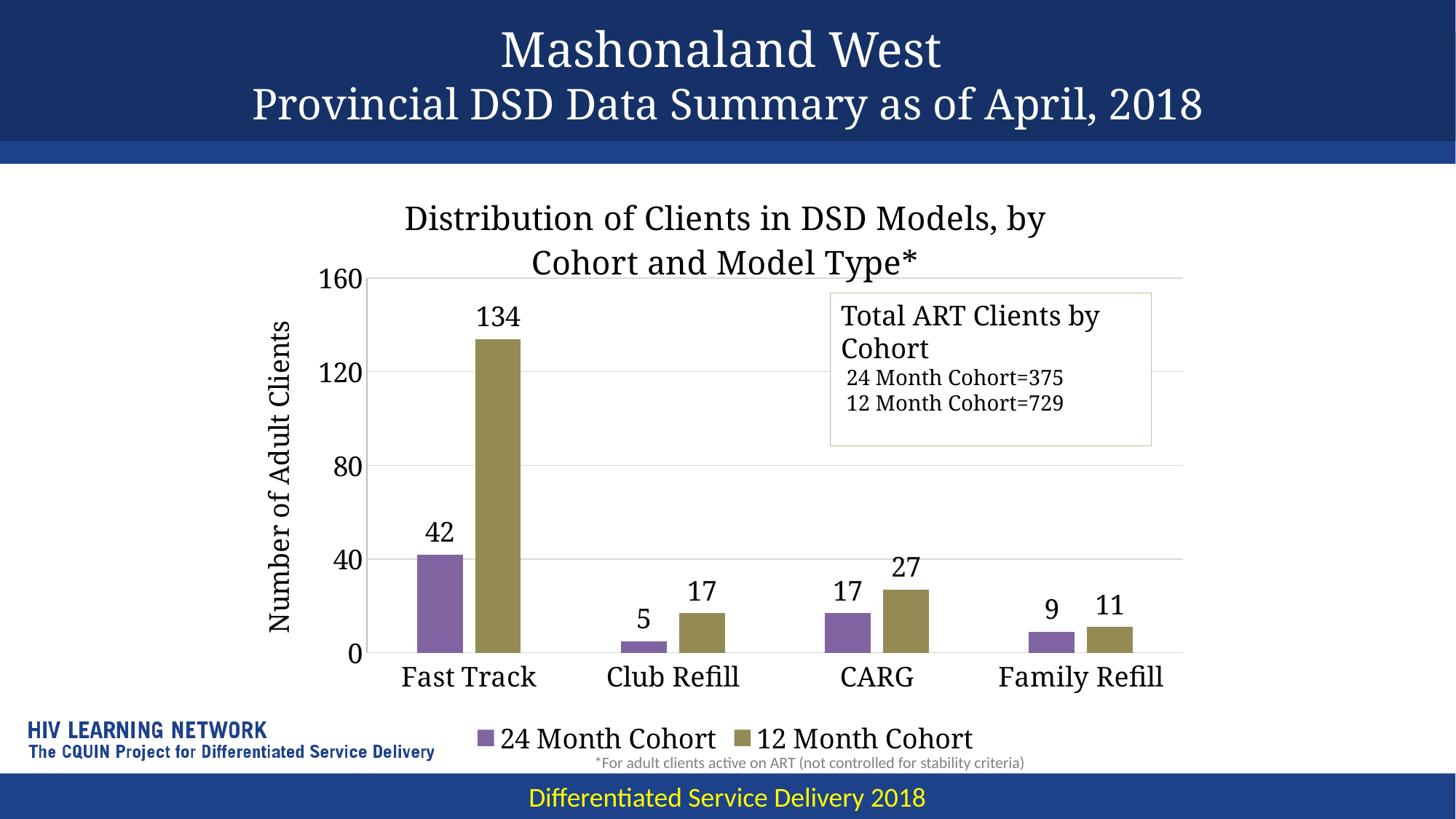
How many model types are shown on the x axis? 4 What is the value for the 12 Month Cohort in the CARG model? 27 How many series does the legend list? 2 Is the value for the 12 Month Cohort in Fast Track greater or less than 120? greater Which model has the lowest value for the 12 Month Cohort? Family Refill What is the label of the y axis? Number of Adult Clients Which model has the highest value for the 24 Month Cohort? Fast Track What is the value for the 24 Month Cohort in the Club Refill model? 5 What is the difference between the 12 Month Cohort and 24 Month Cohort values for Fast Track? 92 What kind of chart is shown on the slide? Bar chart Which is larger for Family Refill: the 24 Month Cohort or the 12 Month Cohort? 12 Month Cohort What is the value for the 12 Month Cohort in the Fast Track model? 134